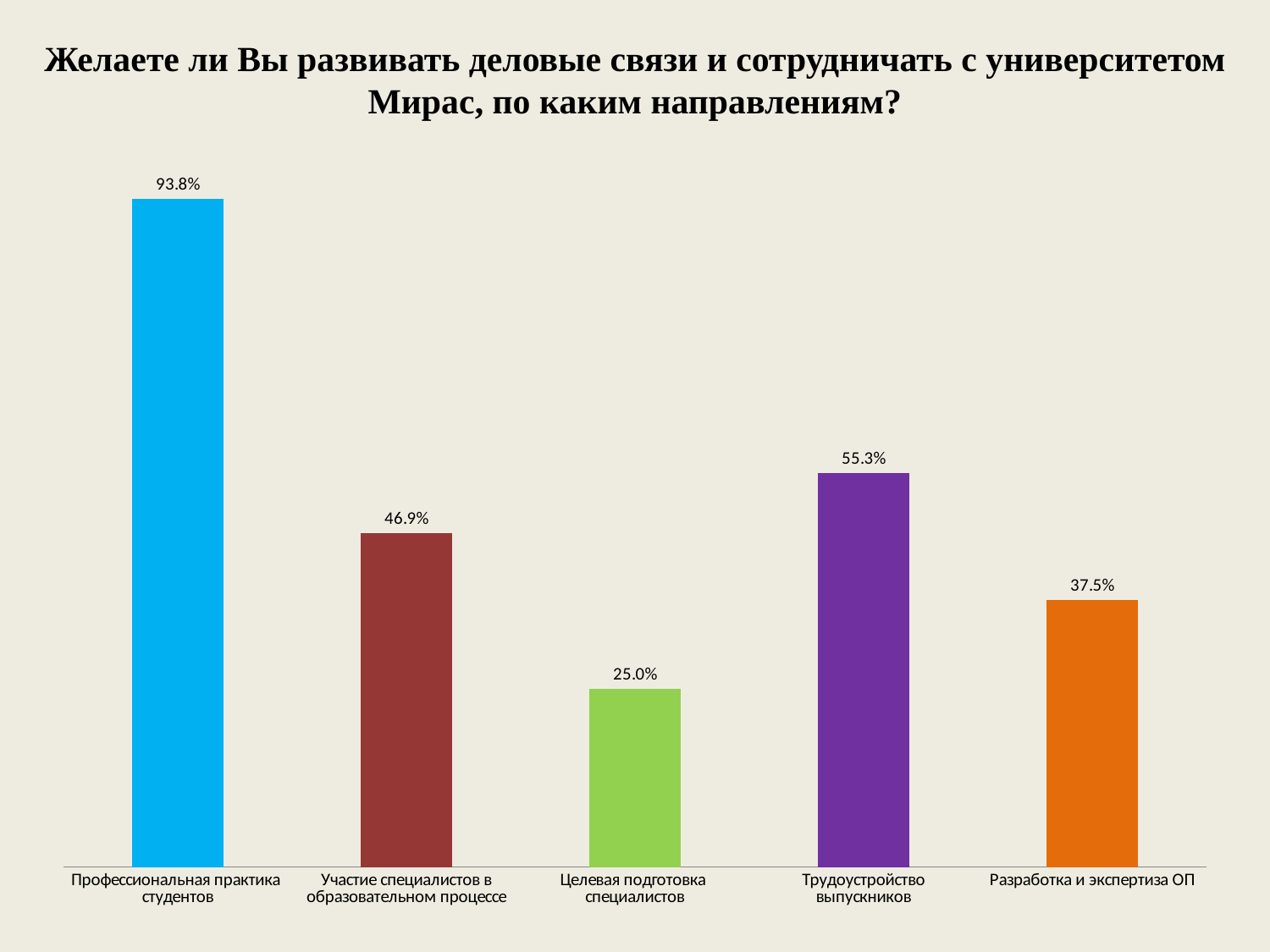
Which category has the highest value? Профессиональная практика студентов What is the value for Трудоустройство выпускников? 55.3% What is the difference between the values for Профессиональная практика студентов and Трудоустройство выпускников? 38.5% How many categories are shown in the chart? 5 What is the value for Профессиональная практика студентов? 93.8% What is the value for Целевая подготовка специалистов? 25.0% What is the value for Разработка и экспертиза ОП? 37.5% Which is larger: the value for Участие специалистов в образовательном процессе or the value for Трудоустройство выпускников? Трудоустройство выпускников Which category has the lowest value? Целевая подготовка специалистов What colour is the bar for Трудоустройство выпускников? Purple What kind of chart is shown on the slide? Bar chart What is the difference between the values for Участие специалистов в образовательном процессе and Разработка и экспертиза ОП? 9.4%